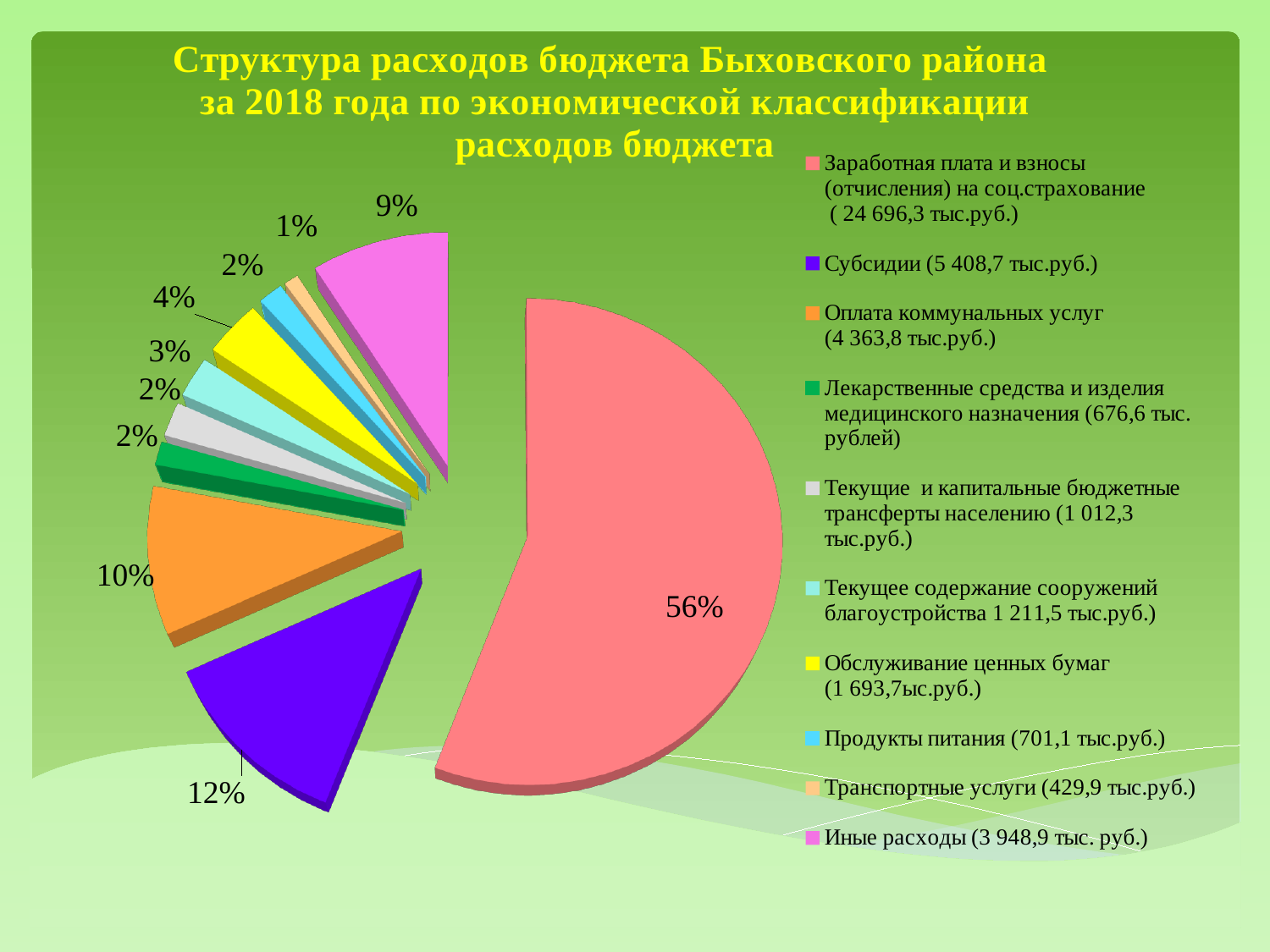
What share of the pie is labelled for Субсидии? 12% What share of the pie is labelled for Заработная плата и взносы (отчисления) на соц.страхование? 56% According to the legend, what amount in тыс.руб. is given for Субсидии? 5 408,7 тыс.руб. What share of the pie is labelled for Иные расходы? 9% Which category has the smallest slice of the pie? Транспортные услуги How many slices does the pie chart have? 10 What kind of chart is shown on the slide? pie chart What is the difference in percentage points between the Субсидии slice and the Оплата коммунальных услуг slice? 2% Which category has the largest slice of the pie? Заработная плата и взносы (отчисления) на соц.страхование Which slice is larger: Иные расходы or Обслуживание ценных бумаг? Иные расходы